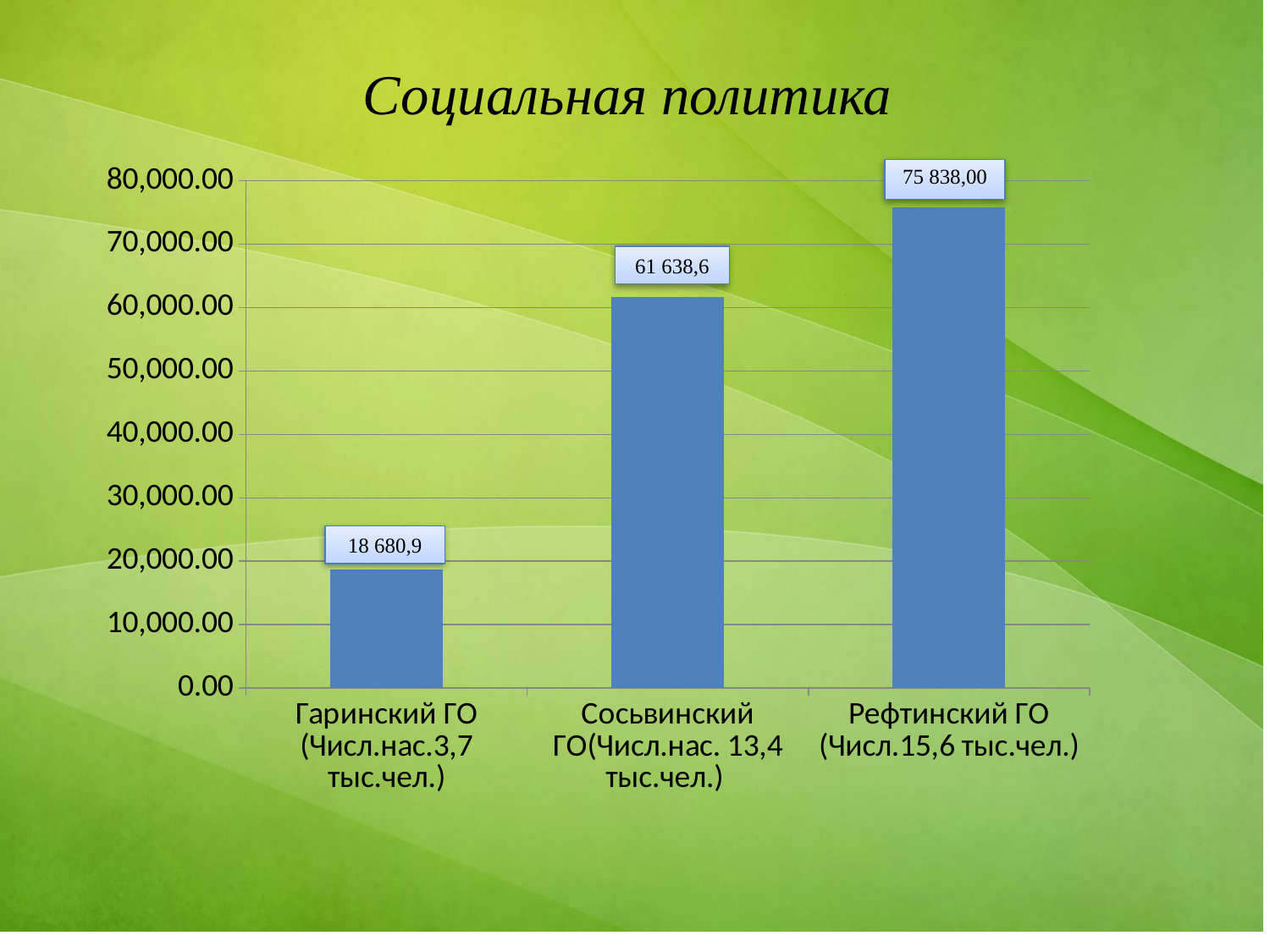
Which category has the lowest value? Гаринский ГО What is the value shown for Гаринский ГО? 18 680,9 Which category has the highest value? Рефтинский ГО What is the difference between the values for Сосьвинский ГО and Гаринский ГО? 42 957,7 Which is larger, the value for Сосьвинский ГО or the value for Гаринский ГО? Сосьвинский ГО Is the value for Сосьвинский ГО greater or less than 60,000.00? greater How many categories are shown on the chart? 3 What is the value shown for Рефтинский ГО? 75 838,00 What kind of chart is shown on the slide? bar chart What is the difference between the values for Рефтинский ГО and Сосьвинский ГО? 14 199,4 What is the title of the slide? Социальная политика What is the value shown for Сосьвинский ГО? 61 638,6